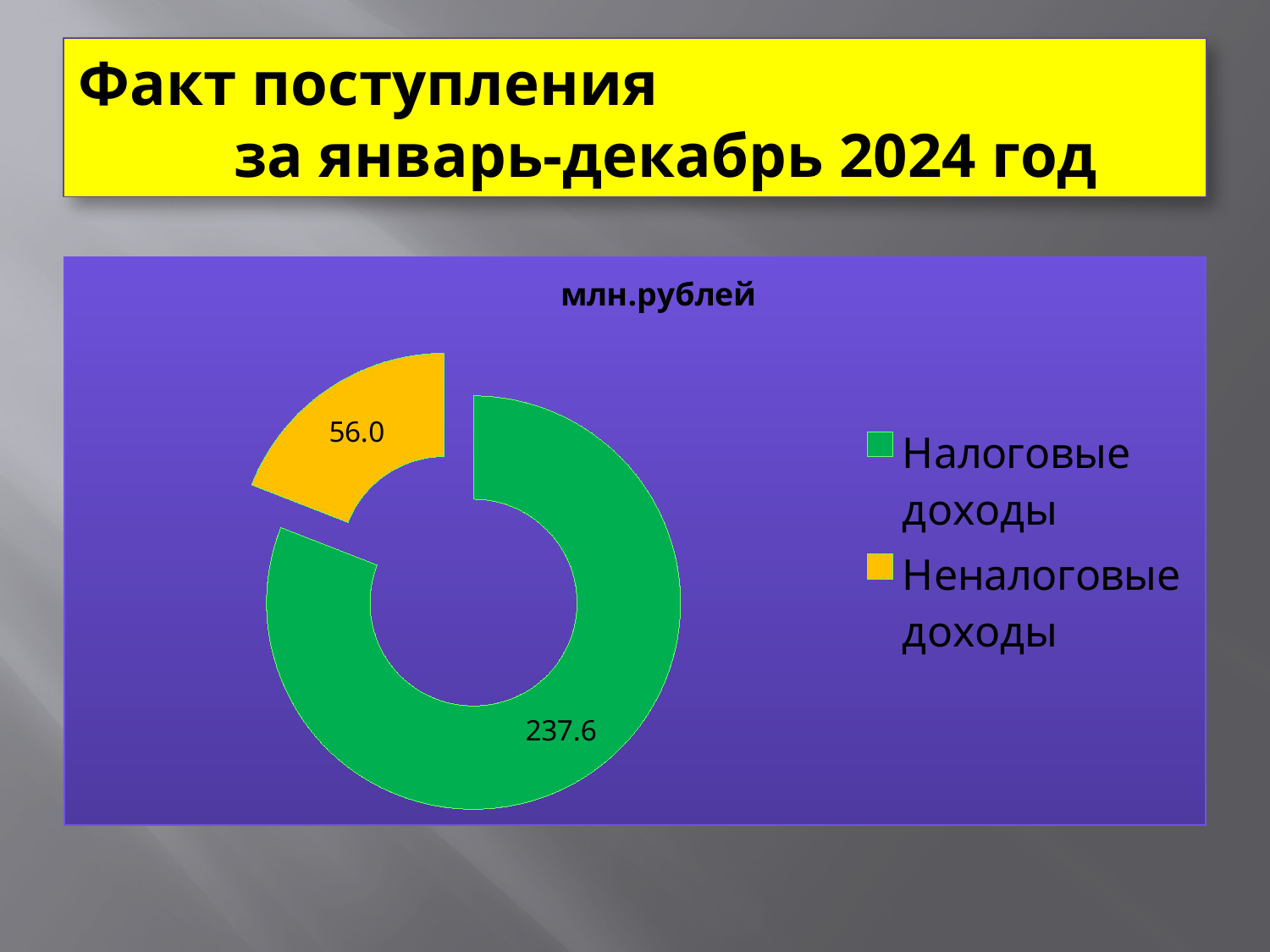
What is the title of the chart? млн.рублей How many categories does the chart show? 2 Which is larger, Налоговые доходы or Неналоговые доходы? Налоговые доходы What kind of chart is shown on the slide? Doughnut chart Which category has the largest value? Налоговые доходы What is the total of the two values shown in the chart? 293.6 What is the value for Налоговые доходы? 237.6 What is the value for Неналоговые доходы? 56.0 Which category has the smallest value? Неналоговые доходы What is the difference between Налоговые доходы and Неналоговые доходы? 181.6 What colour represents Неналоговые доходы in the chart? Orange